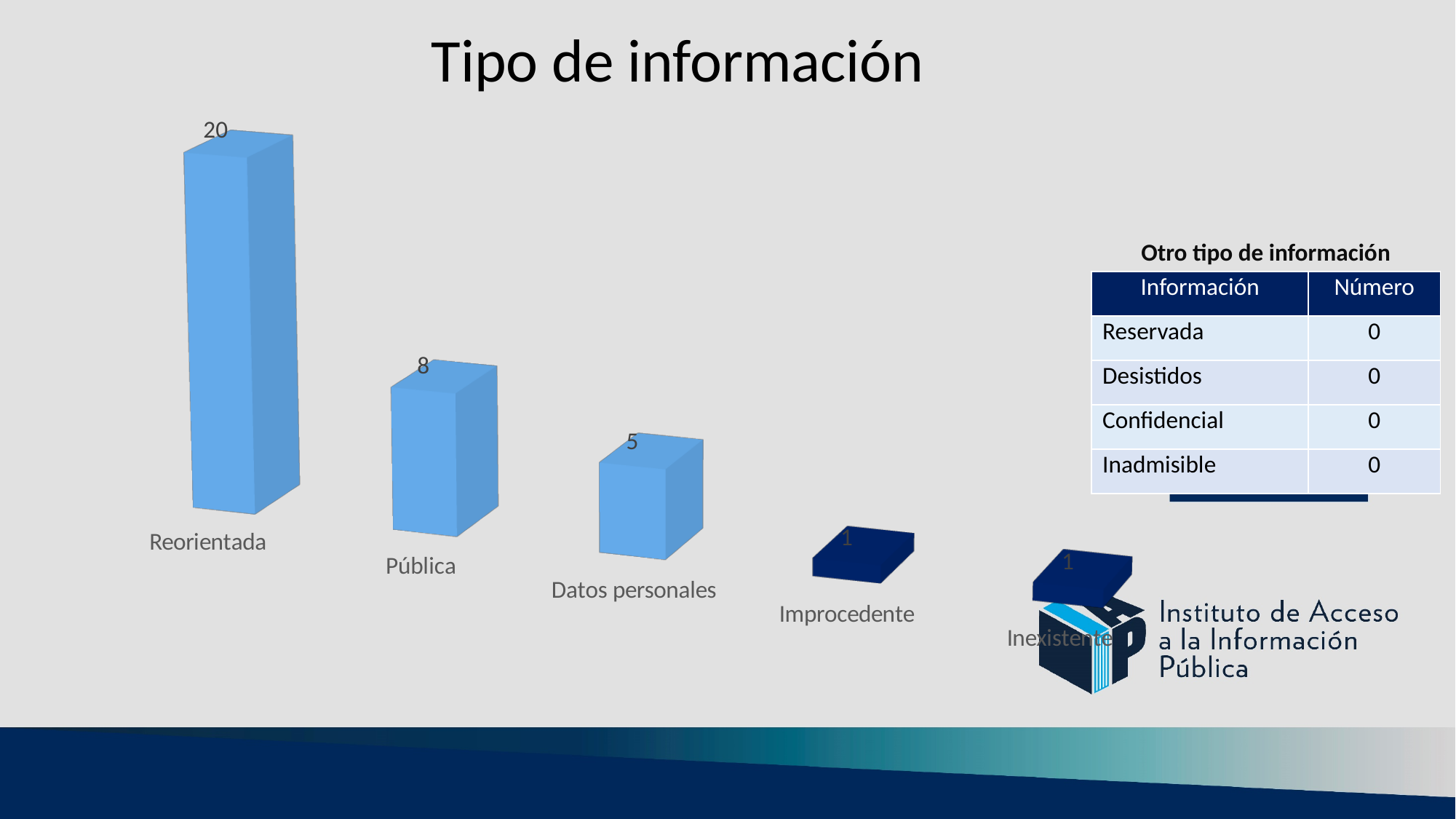
What is the difference between the values for Pública and Datos personales? 3 What is the value for Reorientada? 20 Which category has the highest value? Reorientada Do the values rise or fall from left to right across the categories? fall What is the title of the chart? Tipo de información What is the value for Datos personales? 5 What kind of chart is shown on the slide? bar chart How many categories are shown in the chart? 5 What is the value for Improcedente? 1 Which is larger, the value for Pública or the value for Datos personales? Pública What is the difference between the values for Reorientada and Pública? 12 What is the value for Pública? 8